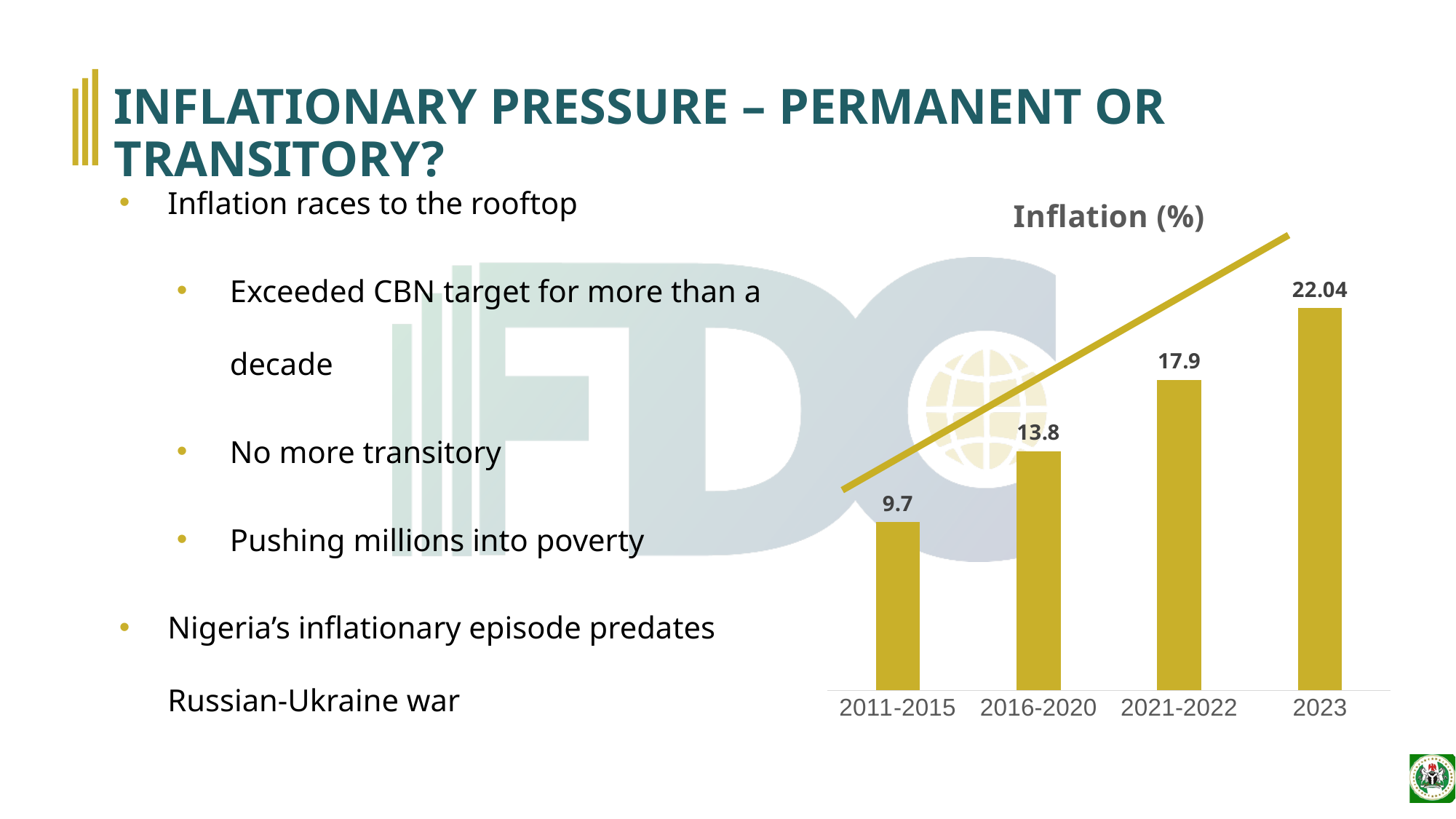
What is the inflation value for 2016-2020? 13.8 What is the inflation value for 2011-2015? 9.7 Which is larger, the inflation value for 2016-2020 or for 2021-2022? 2021-2022 Which period has the highest inflation value? 2023 How many periods are shown on the x axis of the chart? 4 Do the inflation values rise or fall from 2011-2015 to 2023? Rise What is the difference between the inflation values for 2021-2022 and 2016-2020? 4.1 What is the inflation value for 2023? 22.04 What is the inflation value for 2021-2022? 17.9 Which period has the lowest inflation value? 2011-2015 What is the difference between the inflation values for 2023 and 2011-2015? 12.34 What kind of chart is shown on the slide? Bar chart